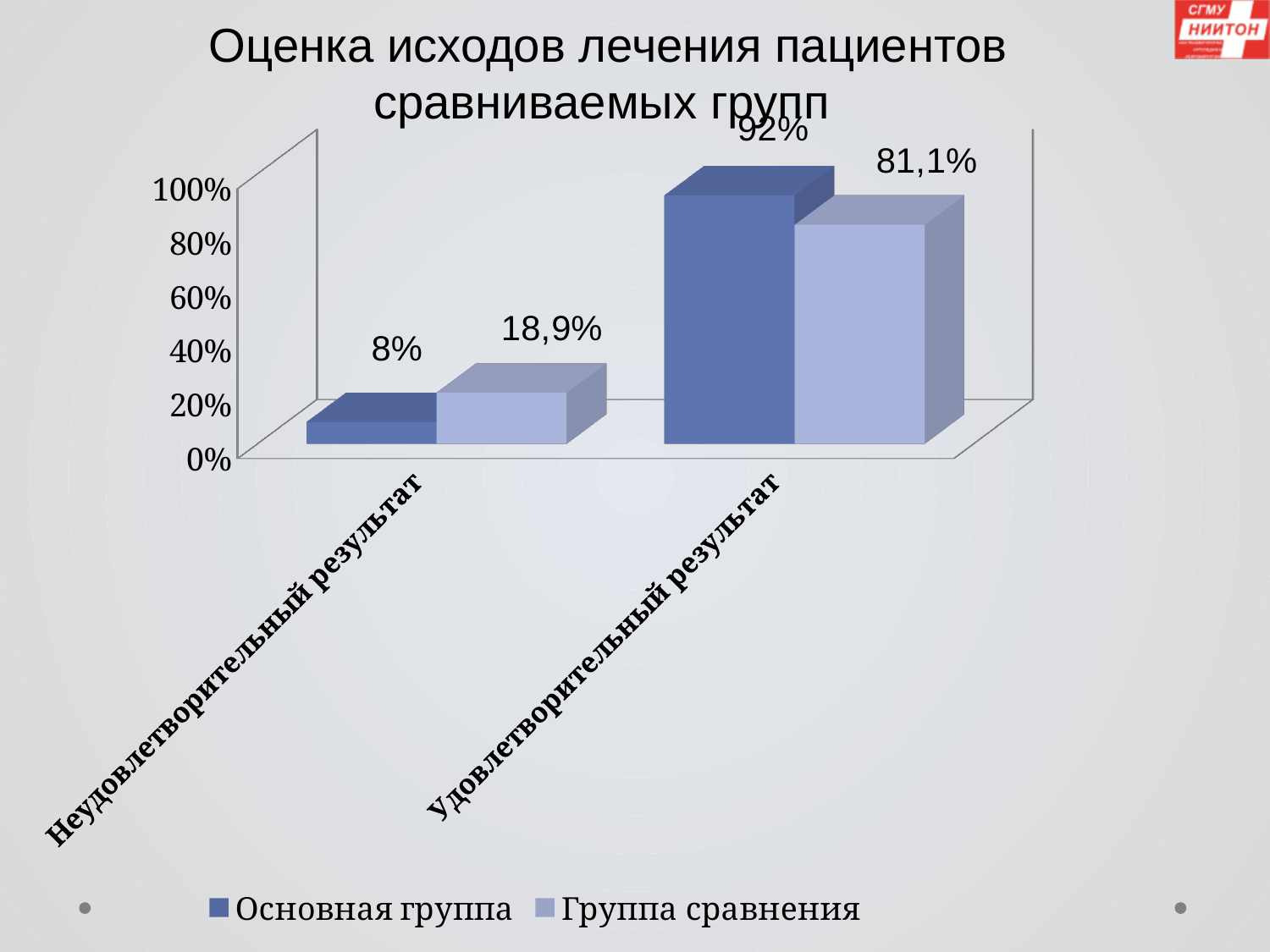
What is the value for Группа сравнения in the Удовлетворительный результат category? 81,1% What is the difference between the Группа сравнения and Основная группа values in the Неудовлетворительный результат category? 10,9% What is the value for Группа сравнения in the Неудовлетворительный результат category? 18,9% Which series has the higher value in the Неудовлетворительный результат category? Группа сравнения Which series has the higher value in the Удовлетворительный результат category? Основная группа What is the value for Основная группа in the Удовлетворительный результат category? 92% What is the value for Основная группа in the Неудовлетворительный результат category? 8% What kind of chart is shown on the slide? Bar chart How many series does the legend list? 2 How many categories are shown on the x axis? 2 What is the difference between the Основная группа and Группа сравнения values in the Удовлетворительный результат category? 10,9% What is the title of the chart on the slide? Оценка исходов лечения пациентов сравниваемых групп